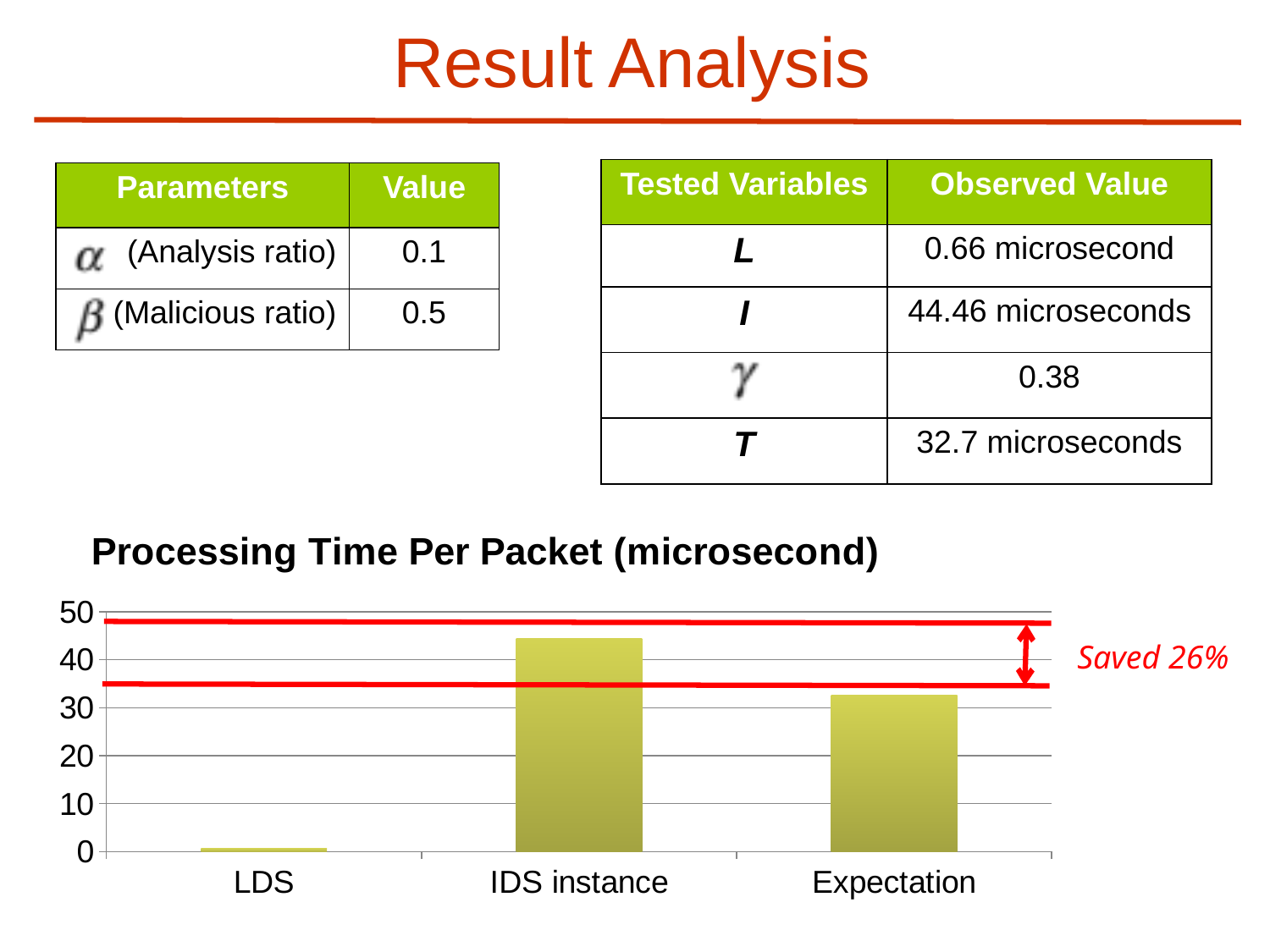
In the 'Processing Time Per Packet (microsecond)' chart, is the value for LDS greater or less than 10? less Which category has the highest bar in the 'Processing Time Per Packet (microsecond)' chart? IDS instance Which category has the lowest bar in the 'Processing Time Per Packet (microsecond)' chart? LDS In the 'Processing Time Per Packet (microsecond)' chart, is the value for IDS instance greater or less than 40? greater In the 'Processing Time Per Packet (microsecond)' chart, which is larger, the bar for LDS or the bar for Expectation? Expectation In the 'Processing Time Per Packet (microsecond)' chart, which is larger, the bar for IDS instance or the bar for Expectation? IDS instance In the 'Processing Time Per Packet (microsecond)' chart, is the value for Expectation greater or less than 40? less How many categories are shown on the x axis of the 'Processing Time Per Packet (microsecond)' chart? 3 What percentage saving is annotated in red next to the 'Processing Time Per Packet (microsecond)' chart? Saved 26% What is the title of the chart on the slide? Processing Time Per Packet (microsecond) What kind of chart is shown under the title 'Processing Time Per Packet (microsecond)'? bar chart